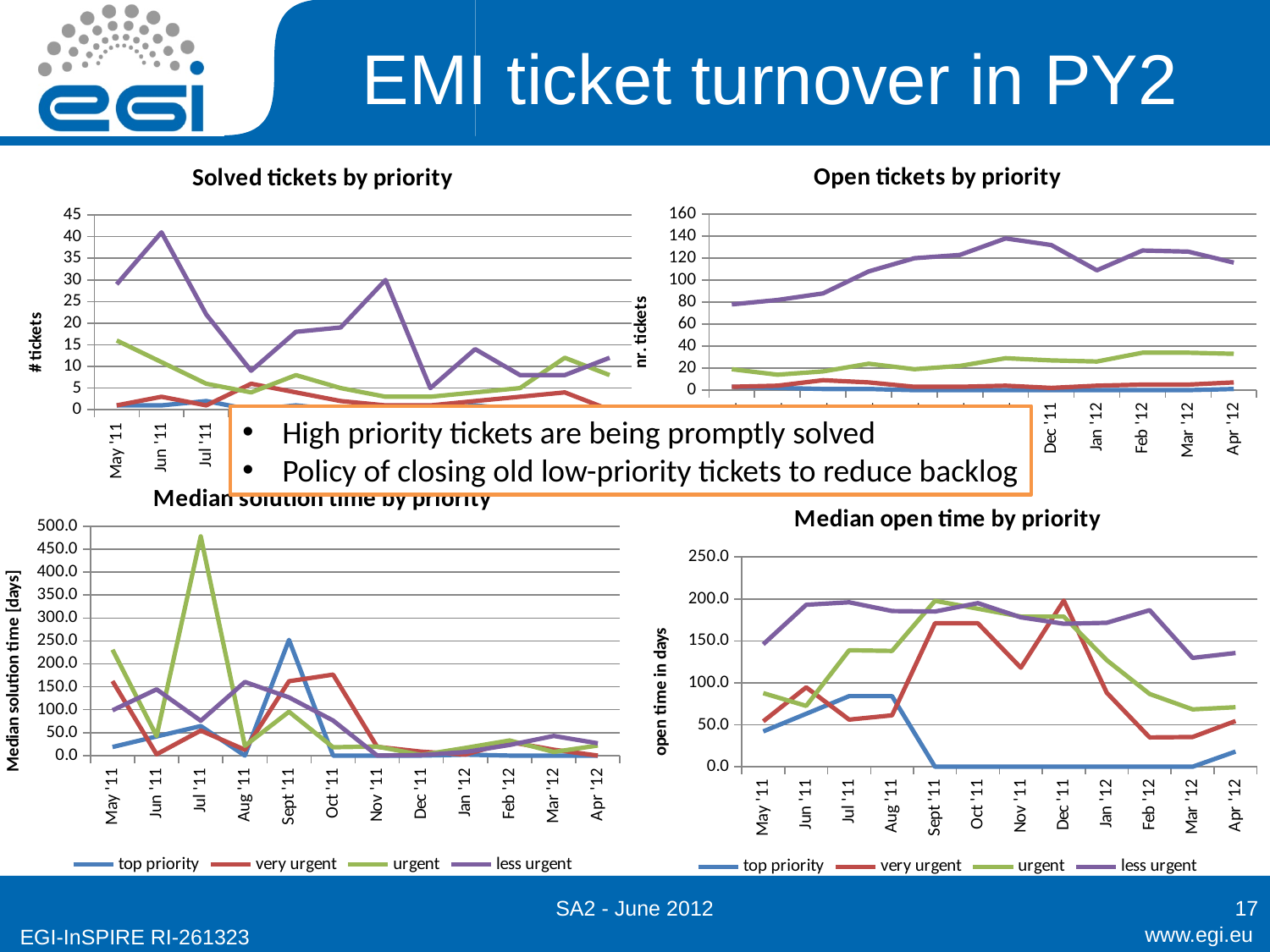
In the 'Median solution time by priority' chart, is the value for urgent at Jul '11 greater or less than 400? greater In the 'Median open time by priority' chart, what is the value for top priority at Oct '11? 0.0 What is the y-axis label of the 'Median open time by priority' chart? open time in days In the 'Median open time by priority' chart, which is larger at Dec '11: very urgent or top priority? very urgent In the 'Median solution time by priority' chart, which series reaches the highest peak? urgent What kind of chart is the 'Median solution time by priority' chart? line chart How many months are shown on the x axis of the 'Median solution time by priority' chart? 12 In the 'Median open time by priority' chart, is the value for very urgent at Feb '12 greater or less than 50? less In the 'Median open time by priority' chart, is the value for less urgent at Jul '11 greater or less than 150? greater In the 'Open tickets by priority' chart, does the top (purple) line rise or fall from May '11 to Nov '11? rise How many series does the legend of the 'Median open time by priority' chart list? 4